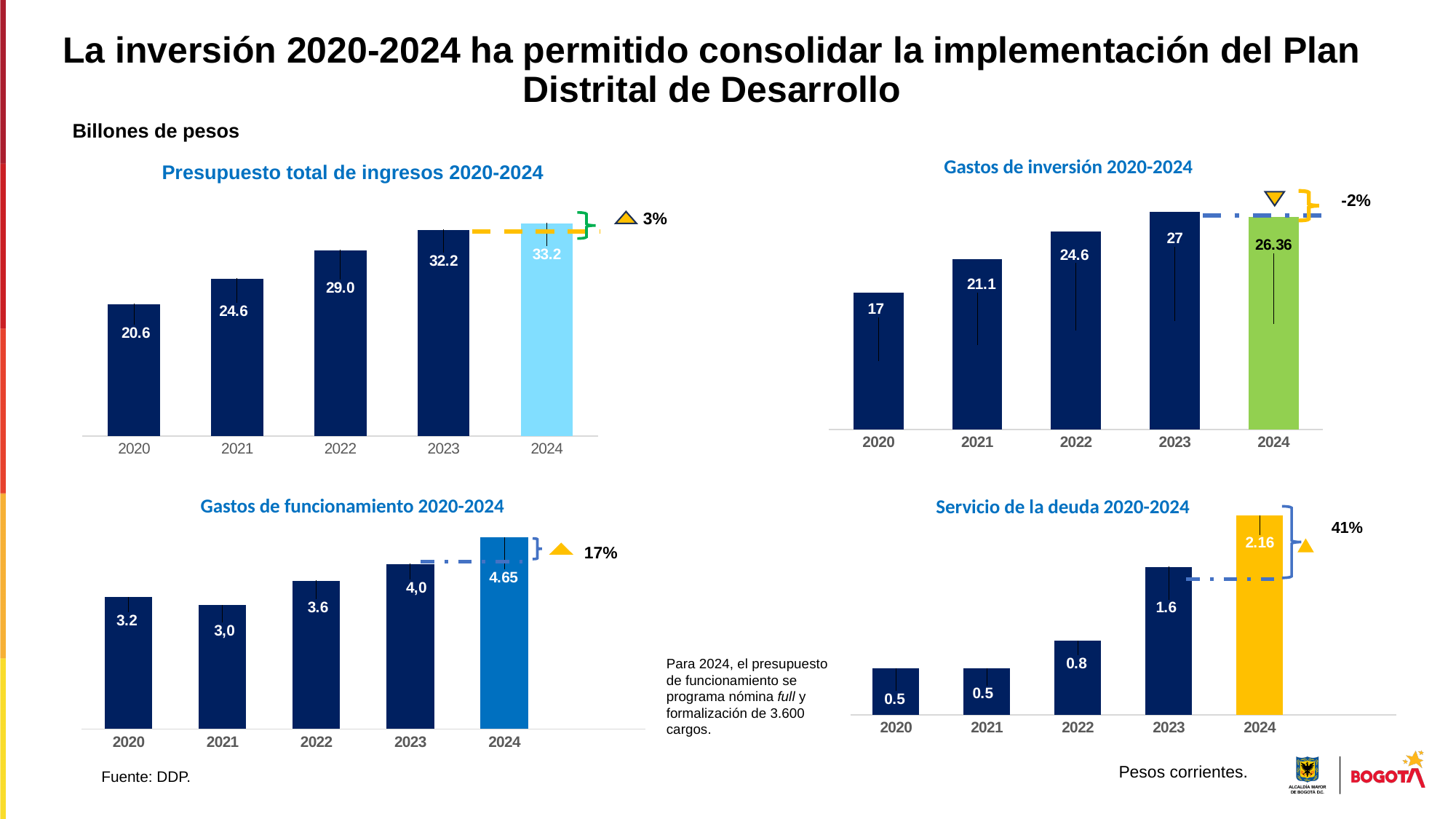
What kind of chart is the 'Servicio de la deuda 2020-2024' chart? bar chart In the 'Servicio de la deuda 2020-2024' chart, do the values generally rise or fall from 2020 to 2024? rise In the 'Presupuesto total de ingresos 2020-2024' chart, which year has the lowest value? 2020 In the 'Gastos de funcionamiento 2020-2024' chart, what is the value for 2024? 4.65 In the 'Presupuesto total de ingresos 2020-2024' chart, what is the value for 2022? 29.0 In the 'Gastos de inversión 2020-2024' chart, which year has the highest value? 2023 In the 'Presupuesto total de ingresos 2020-2024' chart, what is the difference between the 2024 and 2023 values? 1.0 In the 'Gastos de inversión 2020-2024' chart, what percentage change is annotated next to the 2024 bar? -2% In the 'Gastos de funcionamiento 2020-2024' chart, how many years are shown on the x axis? 5 In the 'Gastos de funcionamiento 2020-2024' chart, which is larger, the value for 2020 or the value for 2021? 2020 In the 'Servicio de la deuda 2020-2024' chart, what is the value for 2023? 1.6 In the 'Gastos de inversión 2020-2024' chart, what is the value for 2021? 21.1